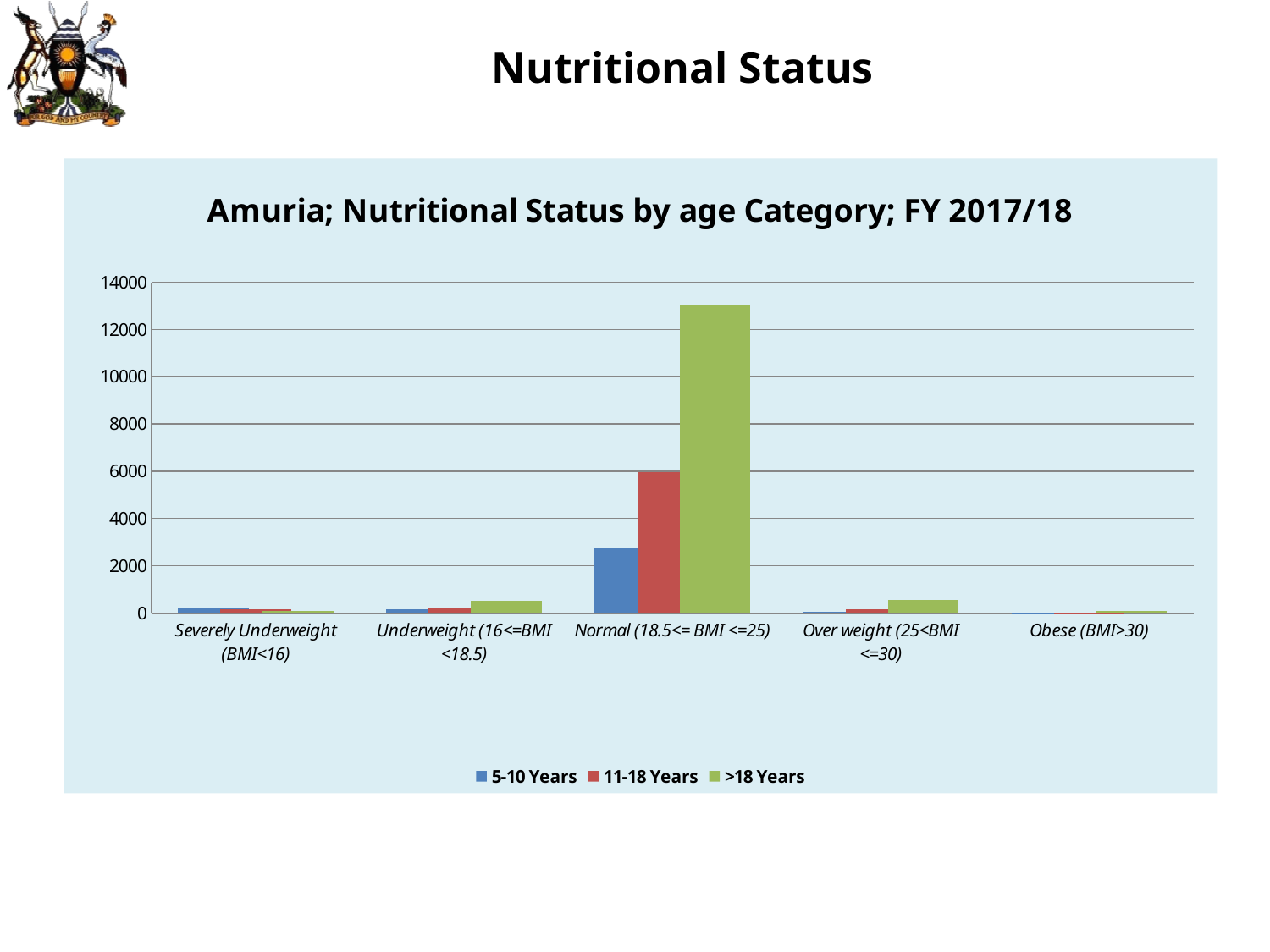
What kind of chart is shown on the slide? bar chart Is the value for >18 Years in the Obese (BMI>30) category greater or less than 2000? less Is the value for 5-10 Years in the Normal (18.5<= BMI <=25) category greater or less than 2000? greater Which colour represents the >18 Years series in the chart? green How many series does the chart's legend list? 3 Which age series has the highest value in the Normal (18.5<= BMI <=25) category? >18 Years What is the title of the chart? Amuria; Nutritional Status by age Category; FY 2017/18 Which BMI category has the highest value for the >18 Years series? Normal (18.5<= BMI <=25) How many BMI categories are shown on the x axis of the chart? 5 Is the value for 11-18 Years in the Normal (18.5<= BMI <=25) category greater or less than 8000? less Which is larger in the Normal (18.5<= BMI <=25) category: the 5-10 Years value or the 11-18 Years value? 11-18 Years